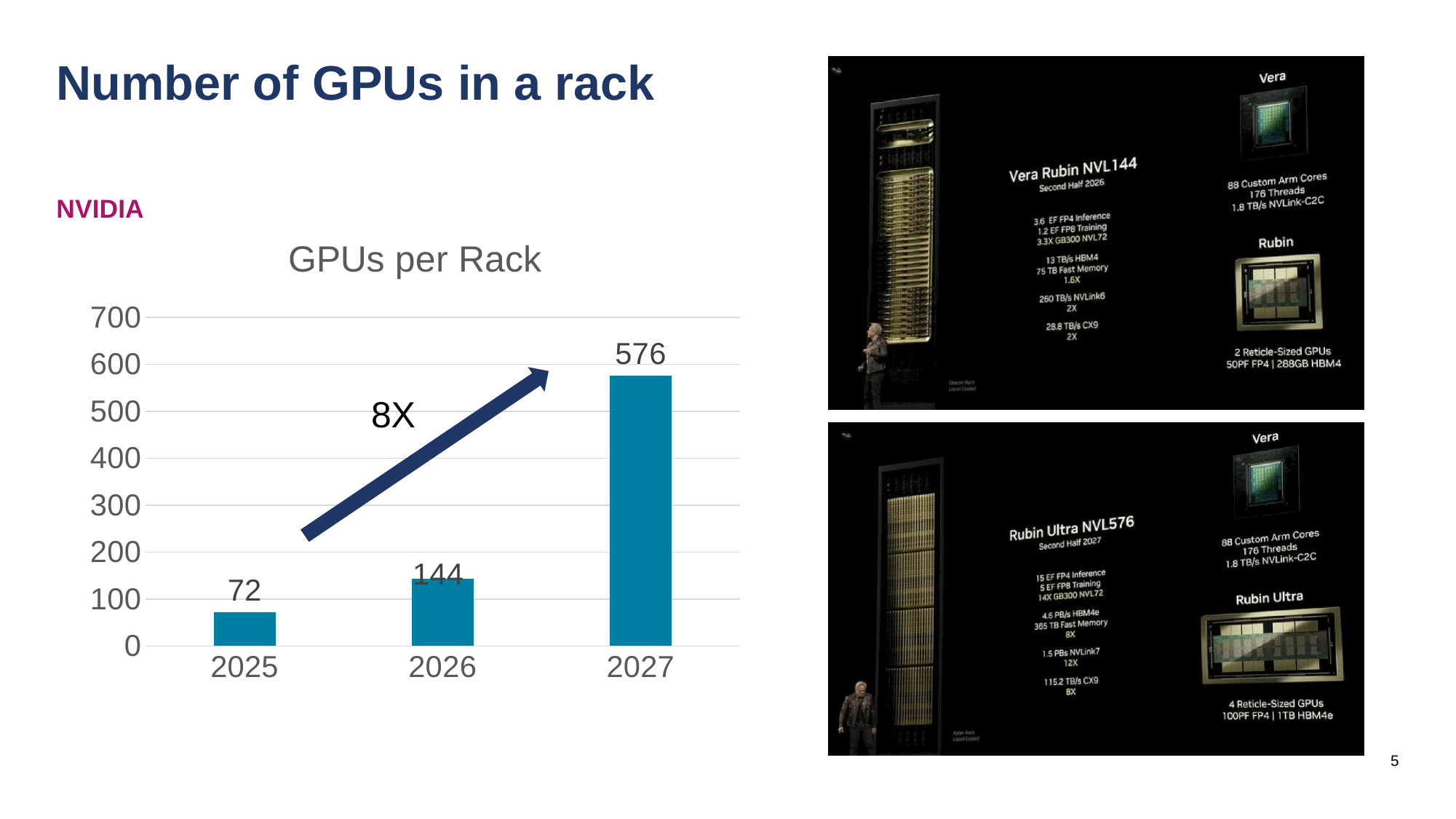
Is the value for 2027 greater or less than 500? greater What is the difference between the 2026 and 2025 values in the GPUs per Rack chart? 72 Do the values in the GPUs per Rack chart rise or fall from 2025 to 2027? rise How many years are shown on the x axis of the GPUs per Rack chart? 3 Which year has the lowest number of GPUs per rack? 2025 Which year has the highest number of GPUs per rack? 2027 What is the difference between the 2027 and 2026 values in the GPUs per Rack chart? 432 What is the value for 2027 in the GPUs per Rack chart? 576 Which is larger in the GPUs per Rack chart, the value for 2026 or the value for 2027? 2027 What is the value for 2026 in the GPUs per Rack chart? 144 What is the value for 2025 in the GPUs per Rack chart? 72 What kind of chart is the GPUs per Rack chart? bar chart